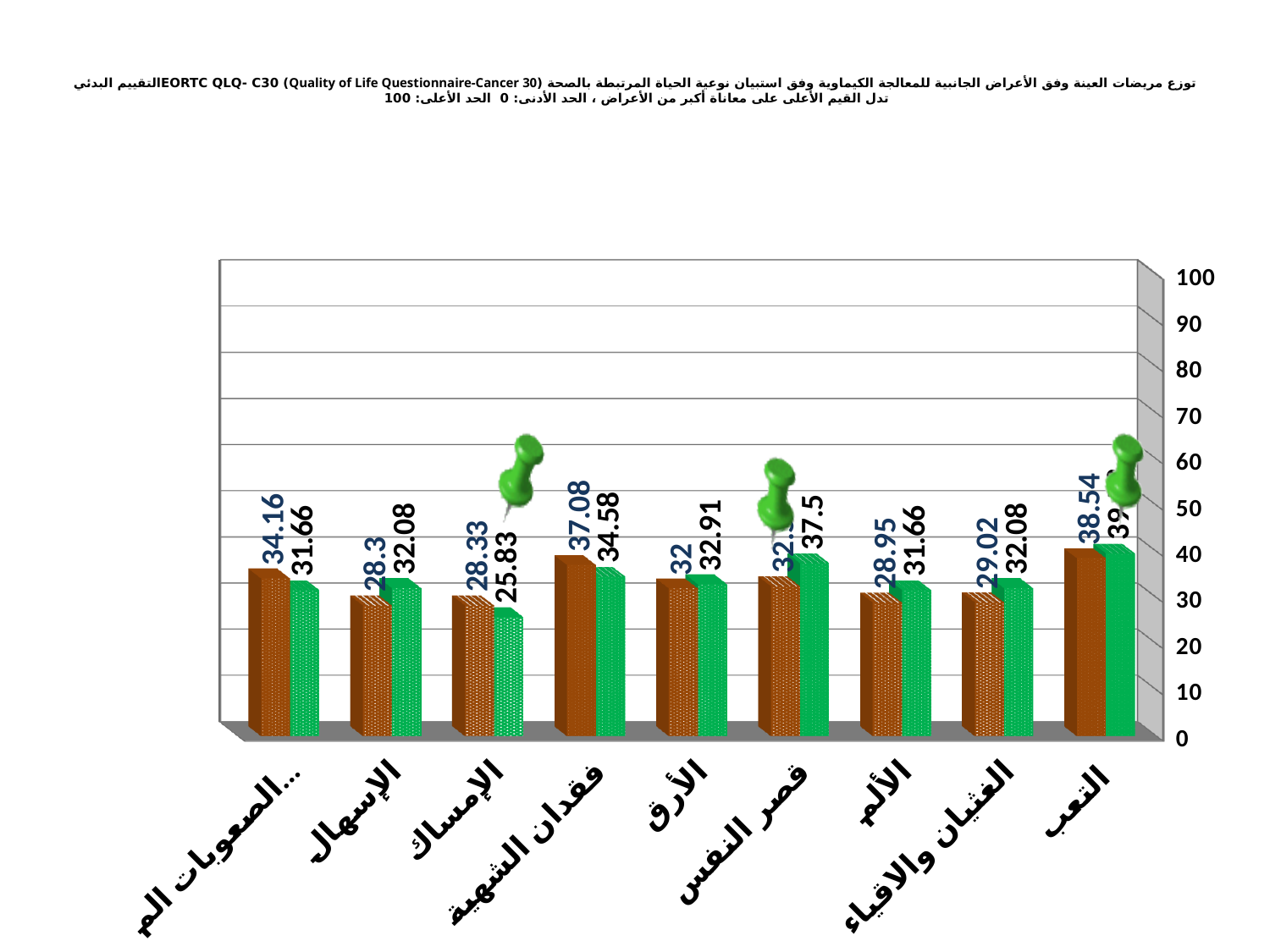
What is the value of the green bar for قصر النفس? 37.5 Which category has the lowest green bar? الإمساك What is the value of the green bar for الإمساك? 25.83 What is the value of the brown bar for الألم? 28.95 What is the difference between the green bar and the brown bar for الأرق? 0.91 Which category has the highest brown bar? التعب How many categories are shown on the x axis of the chart? 9 For الإسهال, which is larger: the brown bar or the green bar? the green bar What is the value of the brown bar for فقدان الشهية? 37.08 What is the value of the green bar for الغثيان والاقياء? 32.08 Is the value of the brown bar for الإمساك greater or less than 30? less What is the difference between the brown bar and the green bar for فقدان الشهية? 2.5